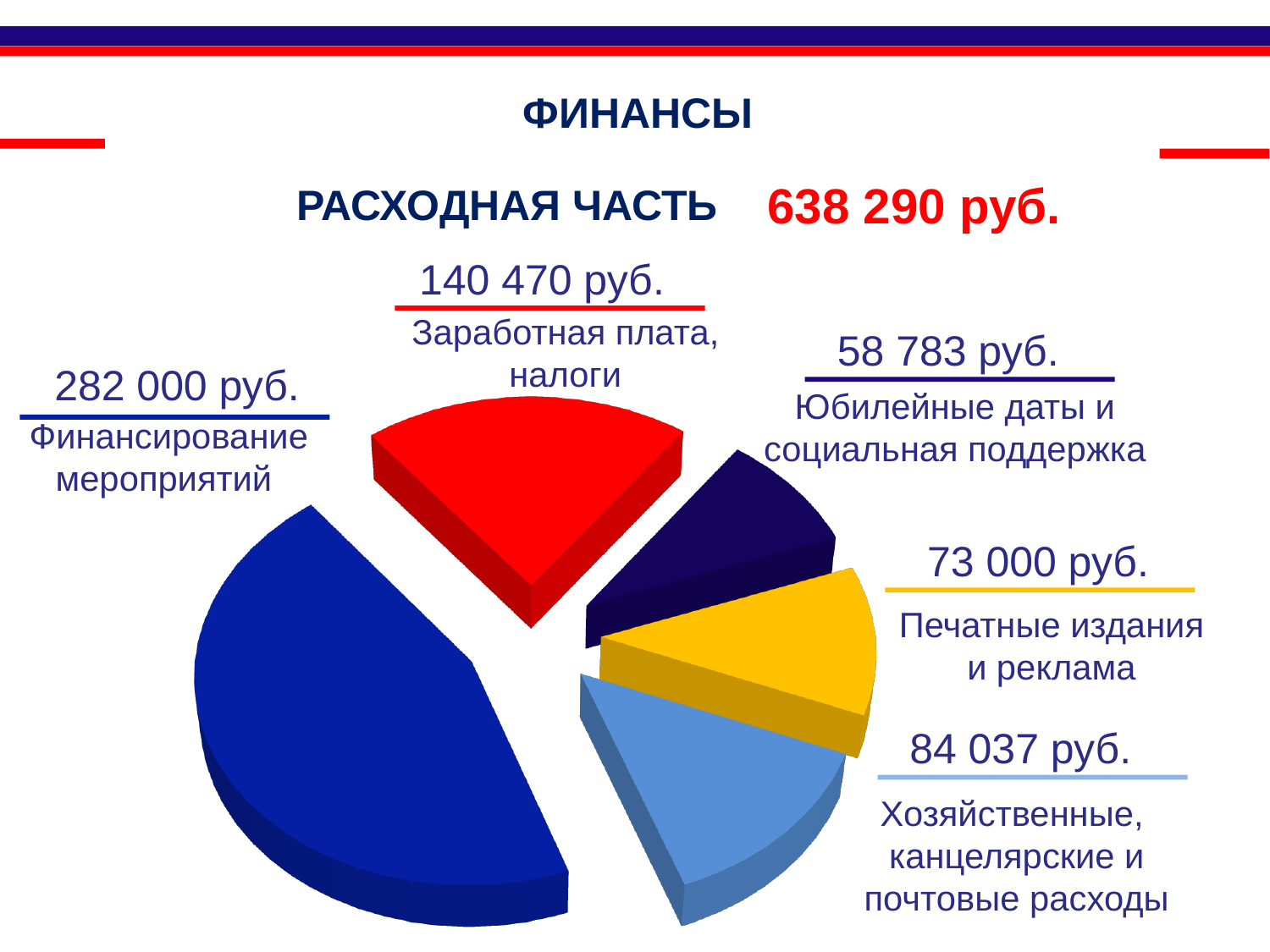
What colour is the slice for Печатные издания и реклама? yellow Which category has the largest value? Финансирование мероприятий What is the value for Финансирование мероприятий? 282 000 руб. What is the value for Юбилейные даты и социальная поддержка? 58 783 руб. What is the value for Хозяйственные, канцелярские и почтовые расходы? 84 037 руб. Which category has the smallest value? Юбилейные даты и социальная поддержка Which is larger: Печатные издания и реклама or Хозяйственные, канцелярские и почтовые расходы? Хозяйственные, канцелярские и почтовые расходы What is the total of all slices (РАСХОДНАЯ ЧАСТЬ)? 638 290 руб. What kind of chart is shown on the slide? pie chart What is the difference between Финансирование мероприятий and Заработная плата, налоги? 141 530 руб. What is the value for Заработная плата, налоги? 140 470 руб. How many slices does the pie chart have? 5